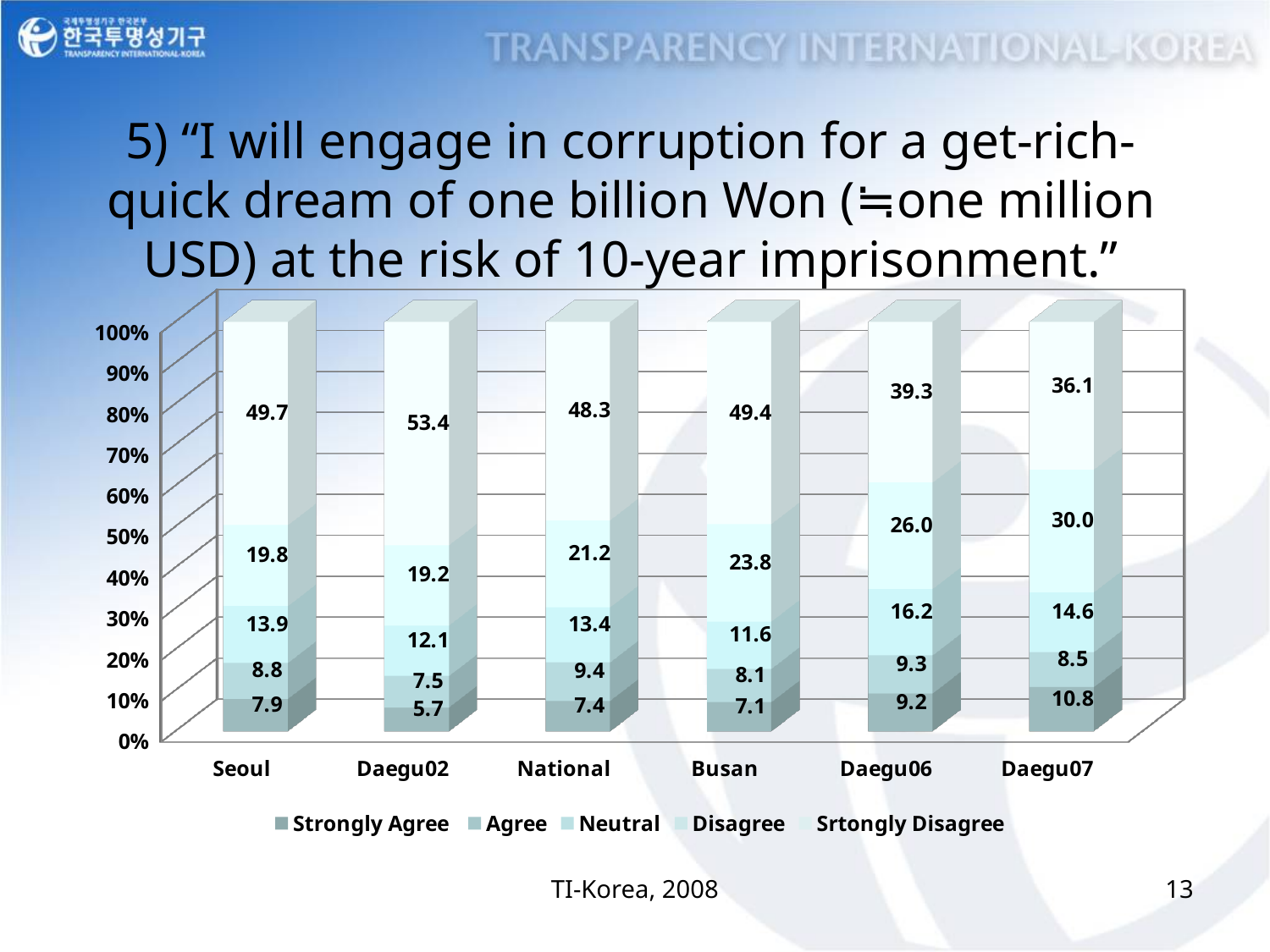
What is the Strongly Disagree value for Daegu02? 53.4 Which category has the highest Disagree value? Daegu07 Which category has the highest Strongly Disagree value? Daegu02 How many series does the legend list? 5 Which category has the lowest Strongly Agree value? Daegu02 What is the Neutral value for Daegu06? 16.2 What is the Strongly Agree value for Daegu07? 10.8 What is the Disagree value for Busan? 23.8 How many categories are shown on the x axis? 6 Which is larger, the Neutral value for Seoul or the Neutral value for Busan? Seoul What is the difference between the Strongly Disagree values for Seoul and Daegu07? 13.6 What kind of chart is shown on the slide? Stacked bar chart